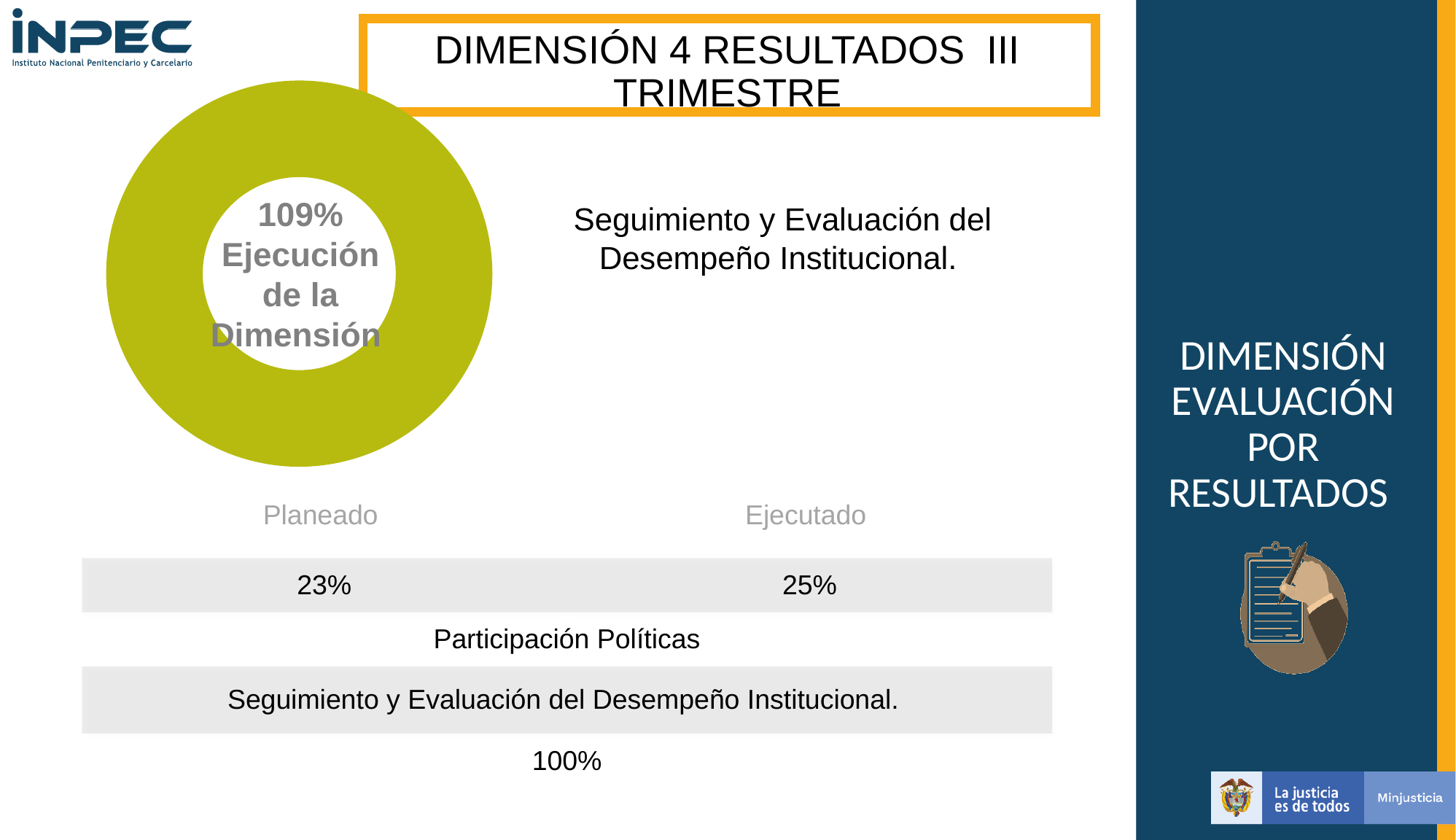
What percentage is printed in the centre of the doughnut chart? 109% How many slices does the doughnut chart show? 1 In the table below the chart, which is larger, Planeado or Ejecutado? Ejecutado What does the text in the centre of the doughnut chart say the 109% represents? Ejecución de la Dimensión What colour is the ring of the doughnut chart? Olive green In the table below the chart, what is the difference between the Ejecutado and Planeado values? 2% In the table below the chart, what is the Planeado value? 23% What value is printed under 'Seguimiento y Evaluación del Desempeño Institucional.' in the table below the chart? 100% What kind of chart is shown on the left of the slide? Doughnut chart In the table below the chart, what is the Ejecutado value? 25%